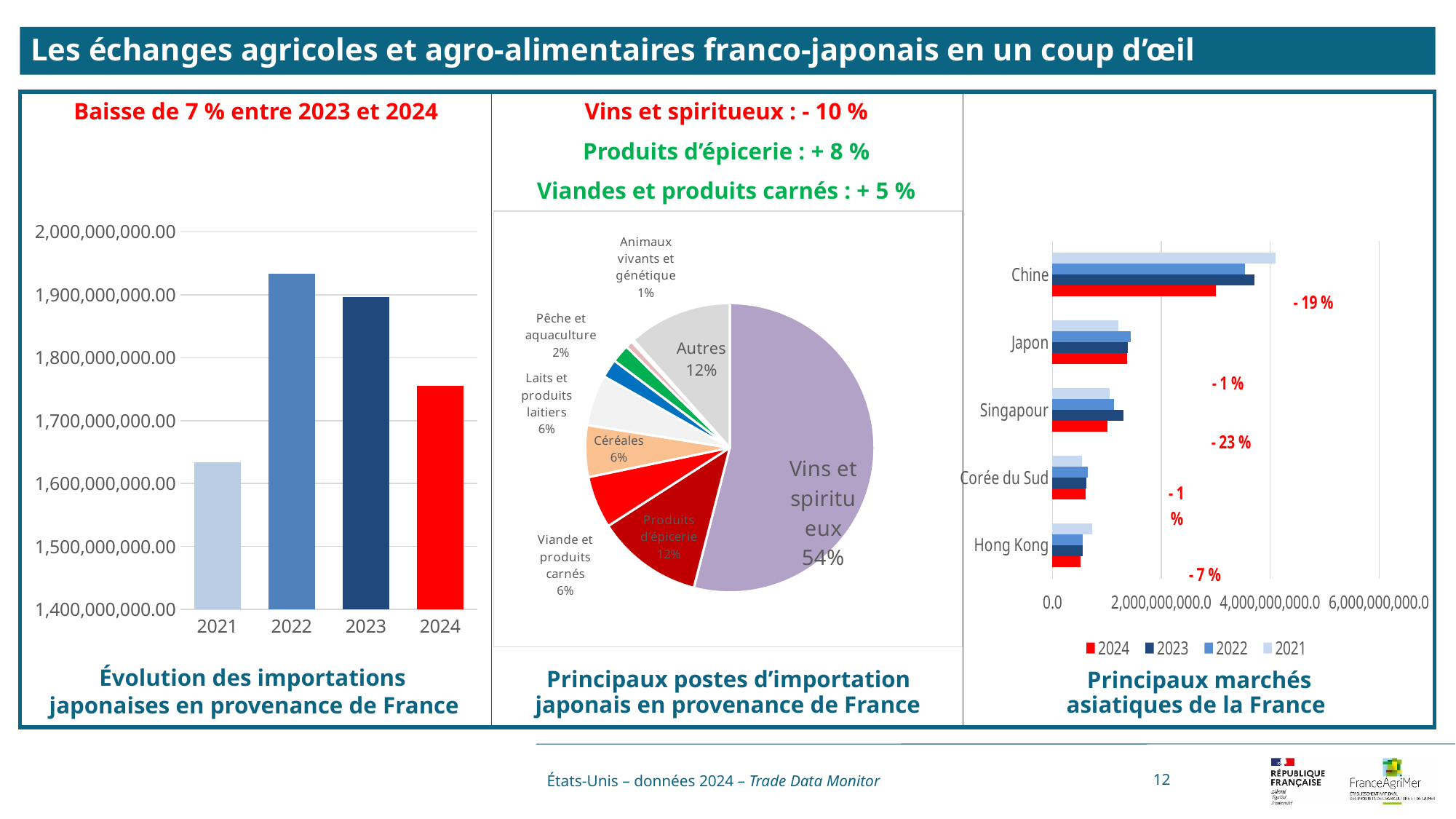
On the chart 'Évolution des importations japonaises en provenance de France', is the value for 2024 greater or less than 1,800,000,000.00? less What kind of chart is 'Évolution des importations japonaises en provenance de France'? bar chart On the chart 'Principaux marchés asiatiques de la France', is the 2024 value for Chine greater or less than 4,000,000,000.0? less On the pie chart 'Principaux postes d'importation japonais en provenance de France', what is the percentage for 'Céréales'? 6% On the chart 'Évolution des importations japonaises en provenance de France', how many years are shown on the x axis? 4 On the chart 'Évolution des importations japonaises en provenance de France', which year has the lowest bar? 2021 On the pie chart 'Principaux postes d'importation japonais en provenance de France', what share does 'Vins et spiritueux' have? 54% On the chart 'Principaux marchés asiatiques de la France', how many series does the legend list? 4 On the chart 'Évolution des importations japonaises en provenance de France', which year has the highest bar? 2022 On the chart 'Principaux marchés asiatiques de la France', which market has the longest bars? Chine On the pie chart 'Principaux postes d'importation japonais en provenance de France', what is the difference in percentage points between 'Vins et spiritueux' and 'Produits d'épicerie'? 42